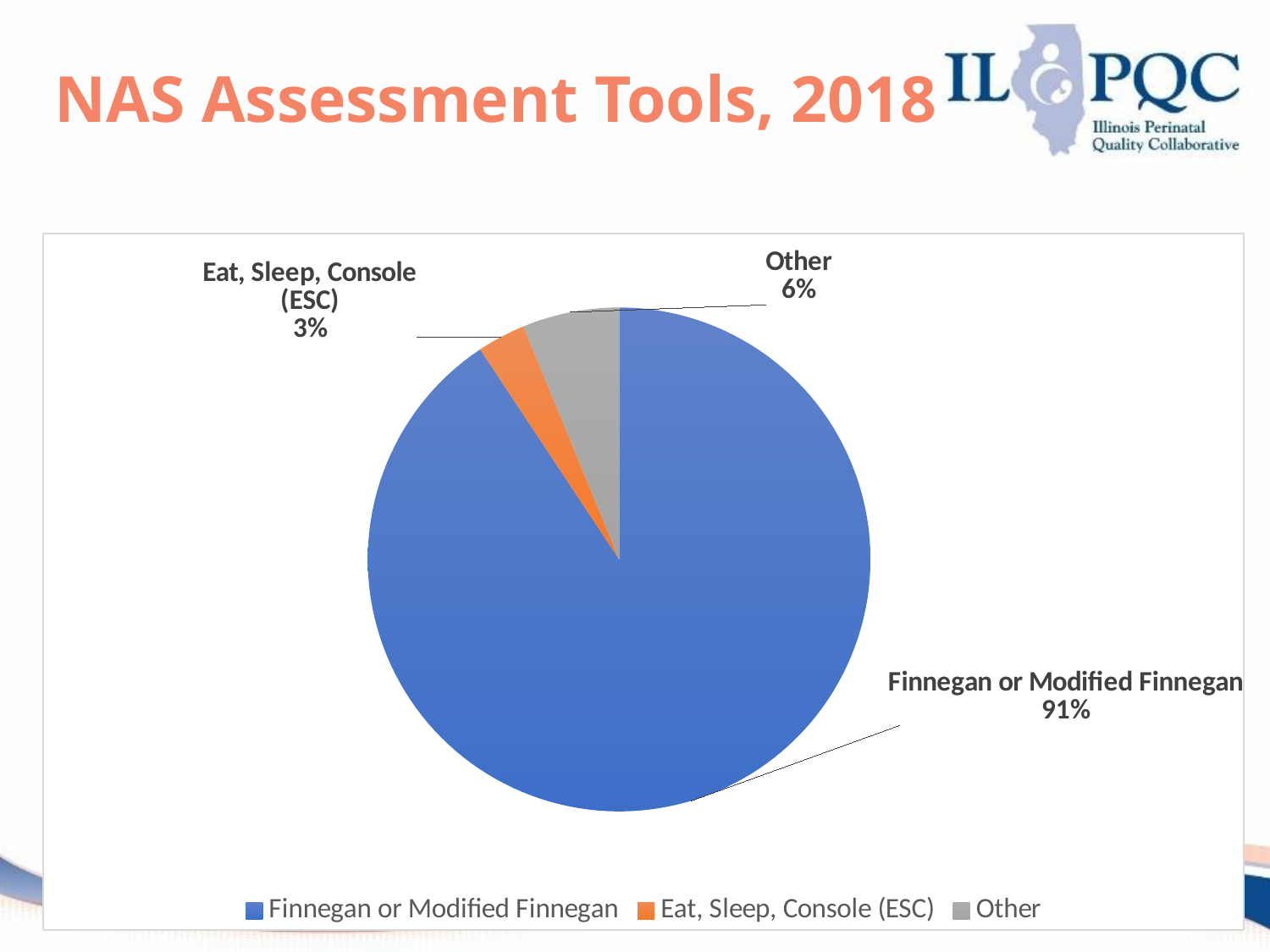
What colour is the slice for Eat, Sleep, Console (ESC)? orange Which category has the largest slice of the pie? Finnegan or Modified Finnegan What is the difference in percentage points between Other and Eat, Sleep, Console (ESC)? 3 What share of the pie does Eat, Sleep, Console (ESC) represent? 3% What is the difference in percentage points between Finnegan or Modified Finnegan and Other? 85 What type of chart is shown on the slide? pie chart What share of the pie does Other represent? 6% How many categories are shown in the pie chart? 3 What is the title of the slide containing the chart? NAS Assessment Tools, 2018 What share of the pie does Finnegan or Modified Finnegan represent? 91% Which category has the smallest slice of the pie? Eat, Sleep, Console (ESC) Which is larger, the share for Other or the share for Eat, Sleep, Console (ESC)? Other